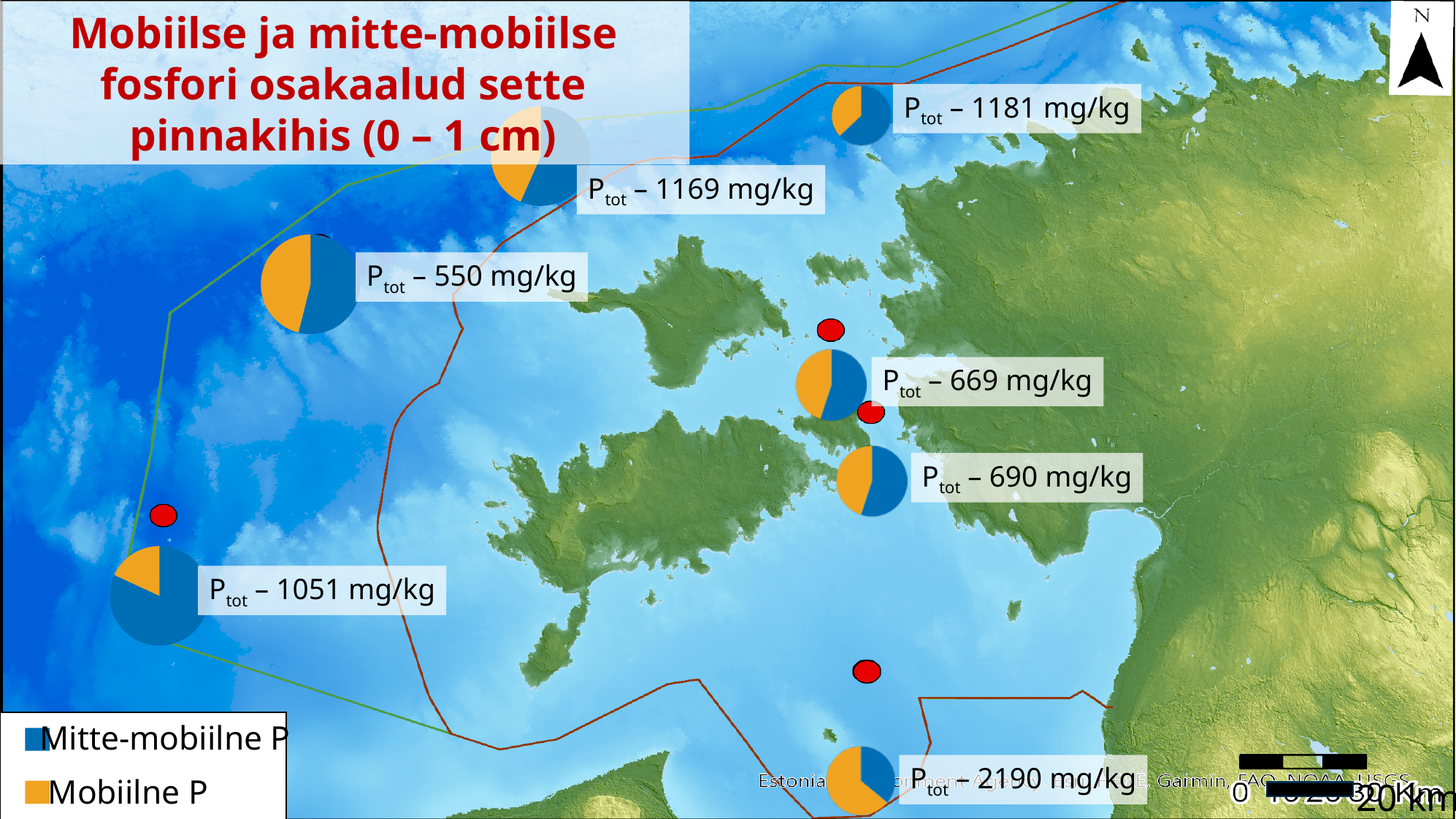
Which is larger, the P_tot value of 1051 mg/kg or the P_tot value of 1169 mg/kg? 1169 mg/kg What is the P_tot value shown next to the pie chart at the westernmost station (the one near the left edge of the map)? 1051 mg/kg How many categories does the legend list? 2 In the pie chart labelled P_tot – 1051 mg/kg, which slice is larger, Mitte-mobiilne P or Mobiilne P? Mitte-mobiilne P Which station has the lowest P_tot value on the map? The station labelled 550 mg/kg (west of the islands) What is the P_tot value shown next to the pie chart at the northernmost station (top of the map)? 1181 mg/kg How many pie charts are shown on the map? 7 What is the difference between the P_tot values of 690 mg/kg and 669 mg/kg? 21 mg/kg What is the difference between the P_tot values of 1181 mg/kg and 1169 mg/kg? 12 mg/kg Which station has the highest P_tot value on the map? The southernmost station, 2190 mg/kg What kind of charts are placed on the map? Pie charts What is the P_tot value shown next to the pie chart at the southernmost station (bottom of the map)? 2190 mg/kg